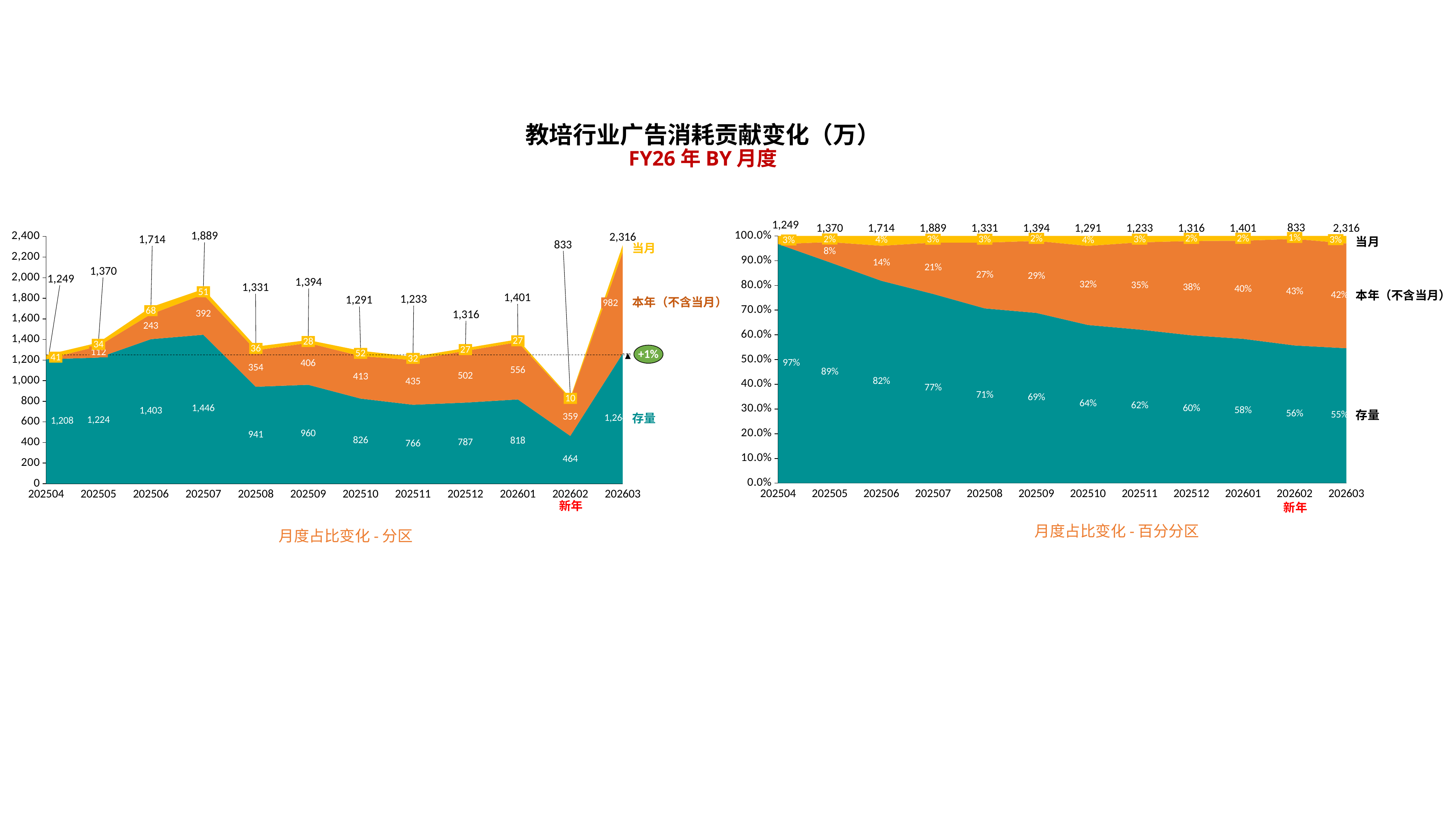
In the right chart (月度占比变化 - 百分分区), what is the 本年（不含当月） share for 202601? 40% In the left chart (月度占比变化 - 分区), what is the total value labeled for 202507? 1,889 In the left chart (月度占比变化 - 分区), which month has the lowest total value? 202602 In the left chart (月度占比变化 - 分区), what is the 本年（不含当月） value for 202603? 982 In the left chart (月度占比变化 - 分区), what is the 存量 value for 202508? 941 In the left chart (月度占比变化 - 分区), which month has the highest total value? 202603 In the right chart (月度占比变化 - 百分分区), what is the 存量 share for 202510? 64% In the left chart (月度占比变化 - 分区), which is larger, the 存量 value for 202506 or for 202507? 202507 In the left chart (月度占比变化 - 分区), what is the difference between the total values for 202603 and 202602? 1,483 How many series are shown in the right chart (月度占比变化 - 百分分区)? 3 In the right chart (月度占比变化 - 百分分区), does the 存量 share rise or fall from 202504 to 202603? fall In the left chart (月度占比变化 - 分区), how many months are shown on the x axis? 12